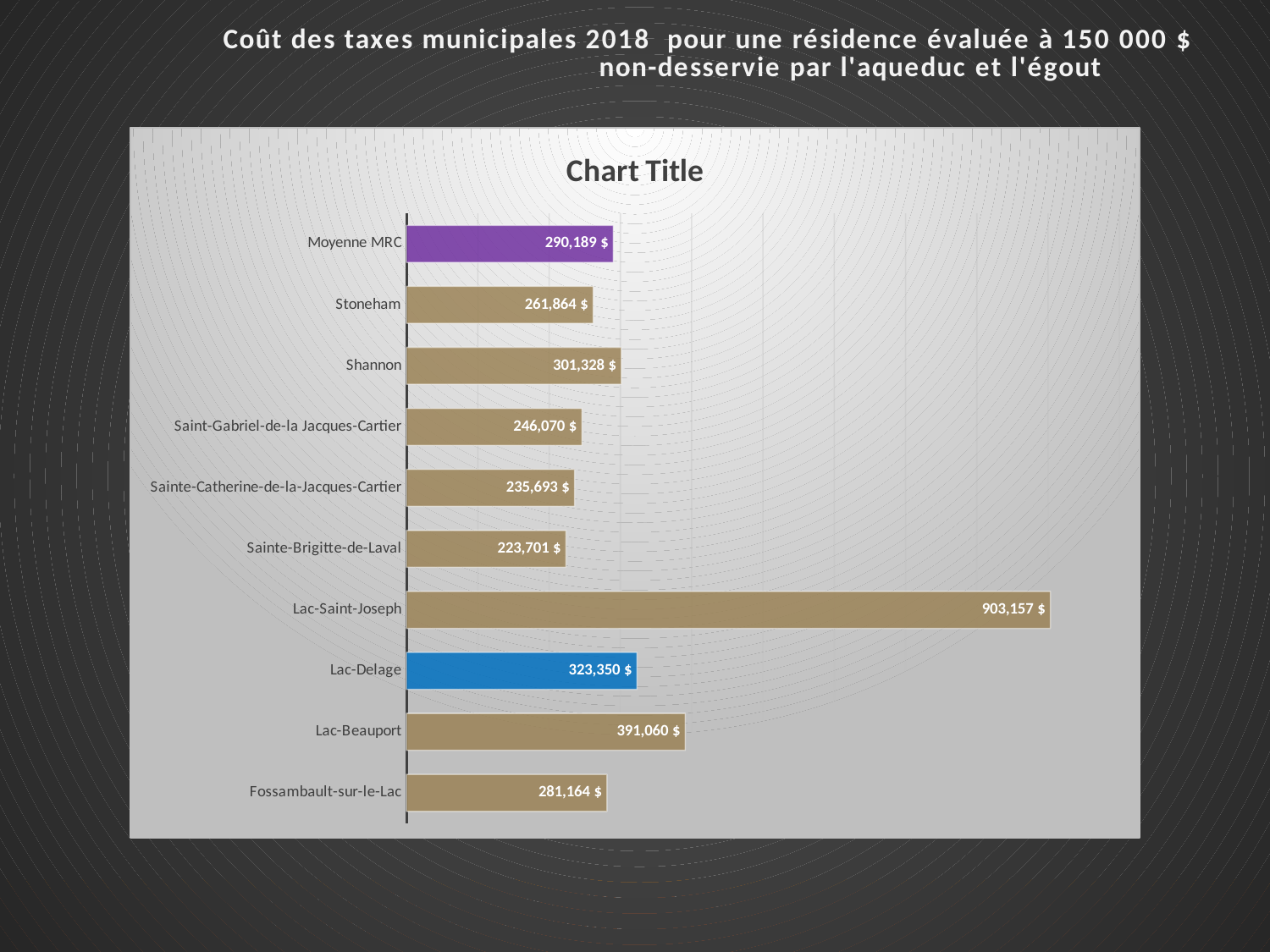
What is the value shown for Sainte-Brigitte-de-Laval? 223,701 $ Which category has the highest value? Lac-Saint-Joseph What kind of chart is shown on the slide? Bar chart How many categories are plotted in the chart? 10 What is the difference between the values for Lac-Beauport and Lac-Delage? 67,710 $ What is the value shown for Moyenne MRC? 290,189 $ What colour is the bar for Lac-Delage? Blue What is the difference between the values for Shannon and Stoneham? 39,464 $ Which category has the lowest value? Sainte-Brigitte-de-Laval Which is larger, the value for Fossambault-sur-le-Lac or the value for Stoneham? Fossambault-sur-le-Lac What is the value shown for Lac-Saint-Joseph? 903,157 $ What is the value shown for Lac-Delage? 323,350 $